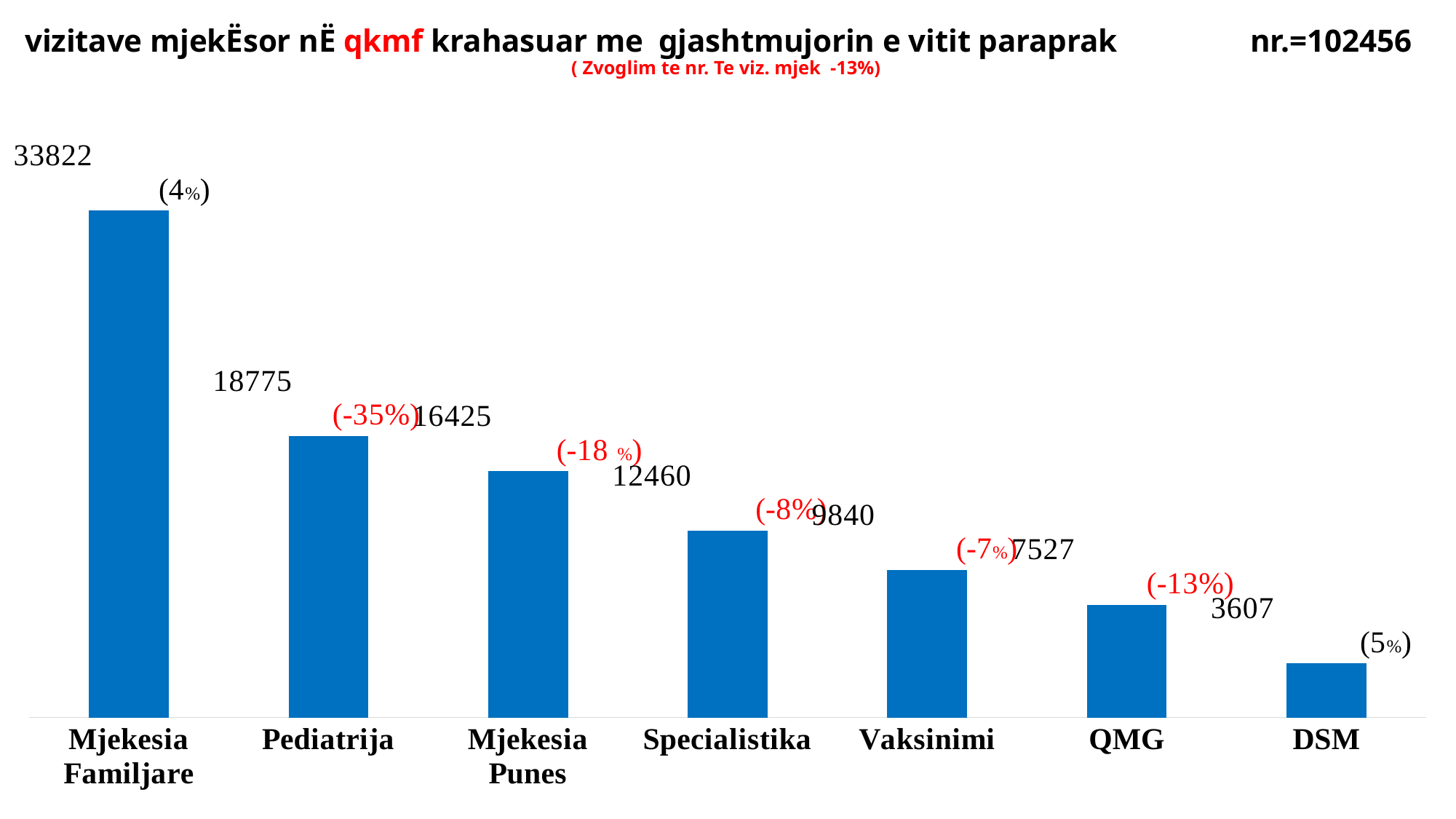
Which category has the highest value? Mjekesia Familjare What kind of chart is shown on the slide? bar chart What is the value for Specialistika? 12460 Do the values rise or fall from left to right along the x axis? fall What is the difference between the values for Mjekesia Familjare and Pediatrija? 15047 How many categories are shown on the x axis? 7 What is the value for Mjekesia Familjare? 33822 What is the value for DSM? 3607 Which category has the lowest value? DSM What is the value for Pediatrija? 18775 What is the difference between the values for Vaksinimi and QMG? 2313 Which is larger, the value for Mjekesia Punes or the value for Specialistika? Mjekesia Punes